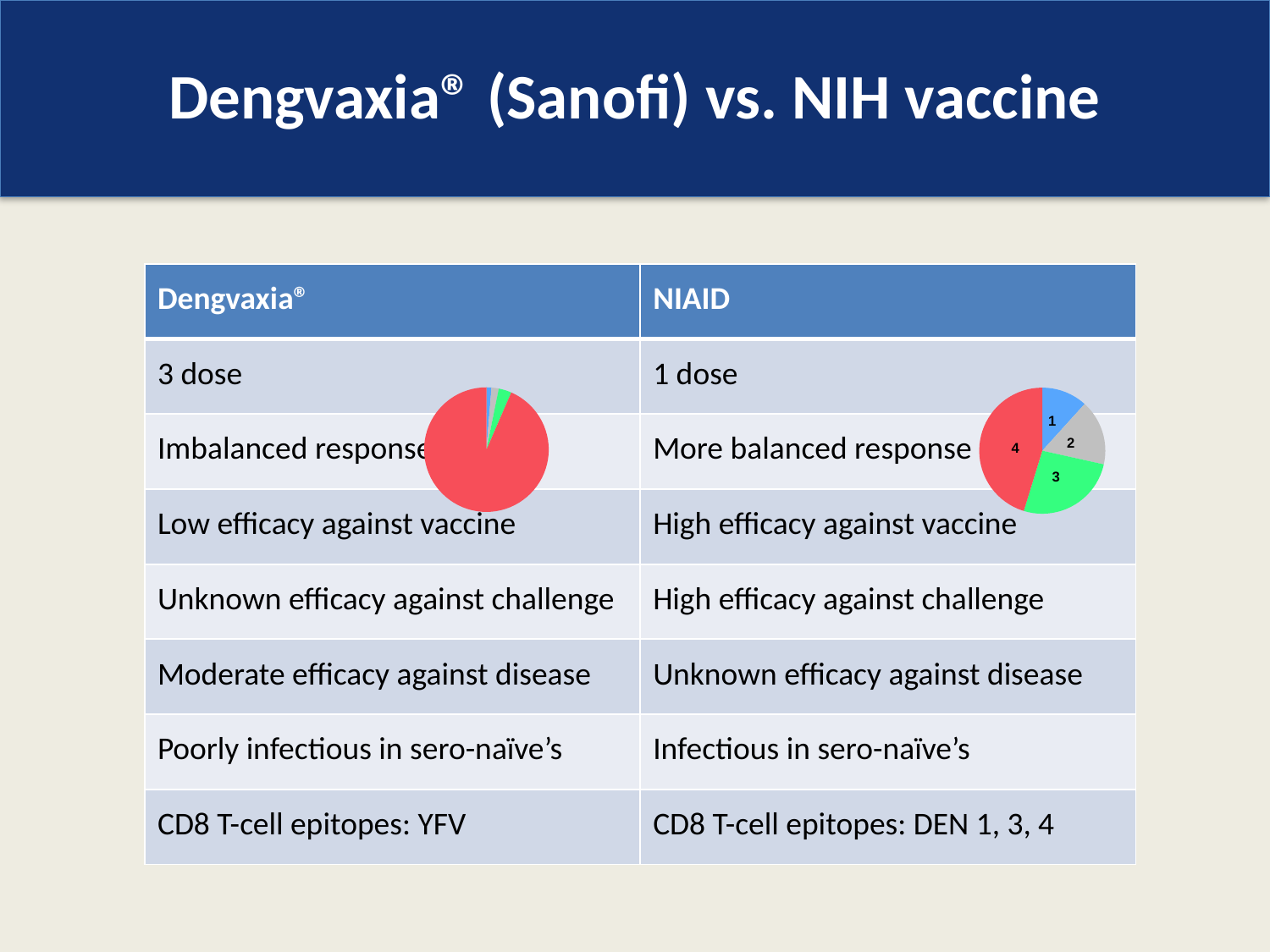
What kind of chart is shown next to 'More balanced response' in the NIAID column? pie chart How many pie charts are on the slide? 2 In the Dengvaxia pie chart (left), which colour takes up almost the entire pie? red In the NIAID pie chart (right), what colour is slice 3? green In the NIAID pie chart (right), what colour is slice 4? red In the NIAID pie chart (right), how many labelled slices are there? 4 In the NIAID pie chart (right), which slice is the largest? 4 In the NIAID pie chart (right), which slice is larger, 4 or 3? 4 In the NIAID pie chart (right), which slice is larger, 3 or 2? 3 What kind of chart is shown next to 'Imbalanced response' in the Dengvaxia column? pie chart Which pie chart shows a more even split among its slices, the Dengvaxia pie (left) or the NIAID pie (right)? NIAID pie (right)